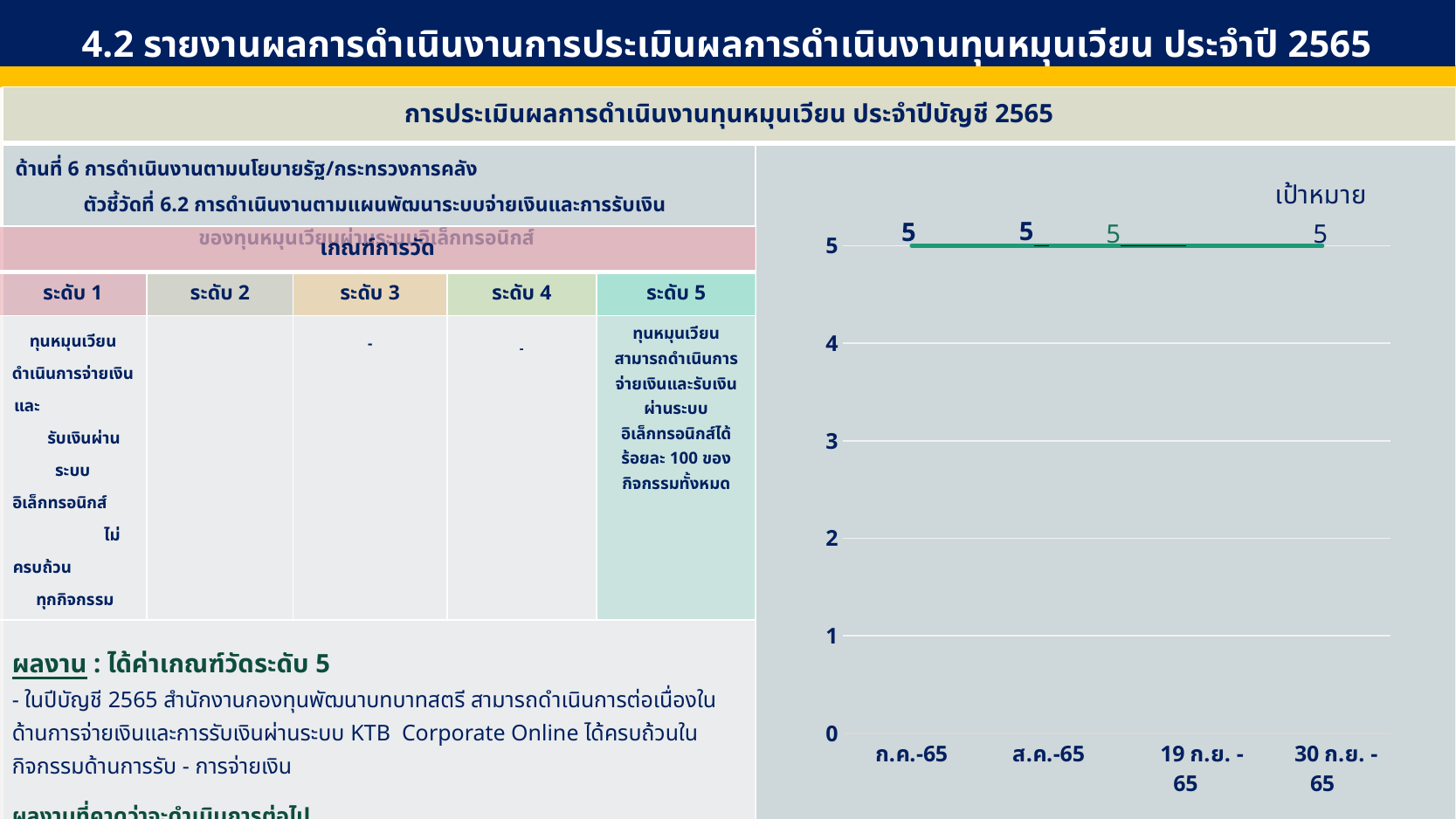
What is the difference between the values for ก.ค.-65 and 30 ก.ย.-65? 0 What kind of chart is shown on the right side of the slide? line chart What is the value plotted for 19 ก.ย.-65? 5 What is the highest tick value shown on the chart's y axis? 5 Do the plotted values rise, fall, or stay flat from ก.ค.-65 to 30 ก.ย.-65? stay flat What is the value plotted for ส.ค.-65? 5 Is the value for ส.ค.-65 greater or less than 3? greater How many data points are plotted along the x axis of the chart? 4 What is the label of the first category on the chart's x axis? ก.ค.-65 What is the value plotted for 30 ก.ย.-65? 5 What is the value plotted for ก.ค.-65? 5